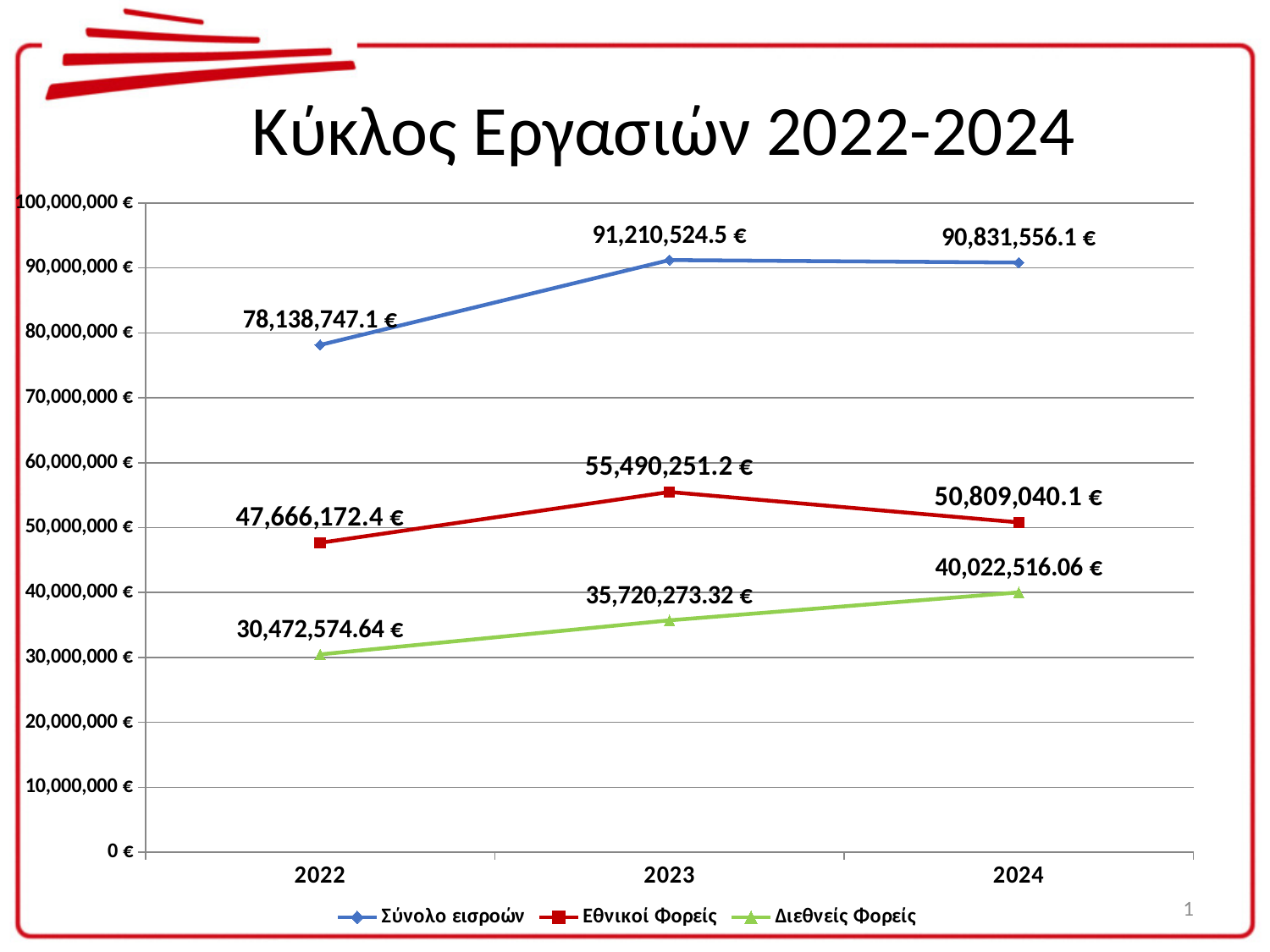
By how much did Διεθνείς Φορείς increase from 2022 to 2024? 9,549,941.42 € What is the value of Εθνικοί Φορείς in 2022? 47,666,172.4 € Does Διεθνείς Φορείς rise or fall from 2022 to 2024? rise How many series does the legend list? 3 In which year is Διεθνείς Φορείς lowest? 2022 What is the value of Σύνολο εισροών in 2023? 91,210,524.5 € Which is larger in 2024, Εθνικοί Φορείς or Διεθνείς Φορείς? Εθνικοί Φορείς What is the value of Διεθνείς Φορείς in 2024? 40,022,516.06 € In which year is Εθνικοί Φορείς highest? 2023 Is the value of Σύνολο εισροών in 2022 greater or less than 80,000,000 €? less What is the difference between Εθνικοί Φορείς in 2023 and in 2022? 7,824,078.8 € How many years are shown on the x axis? 3